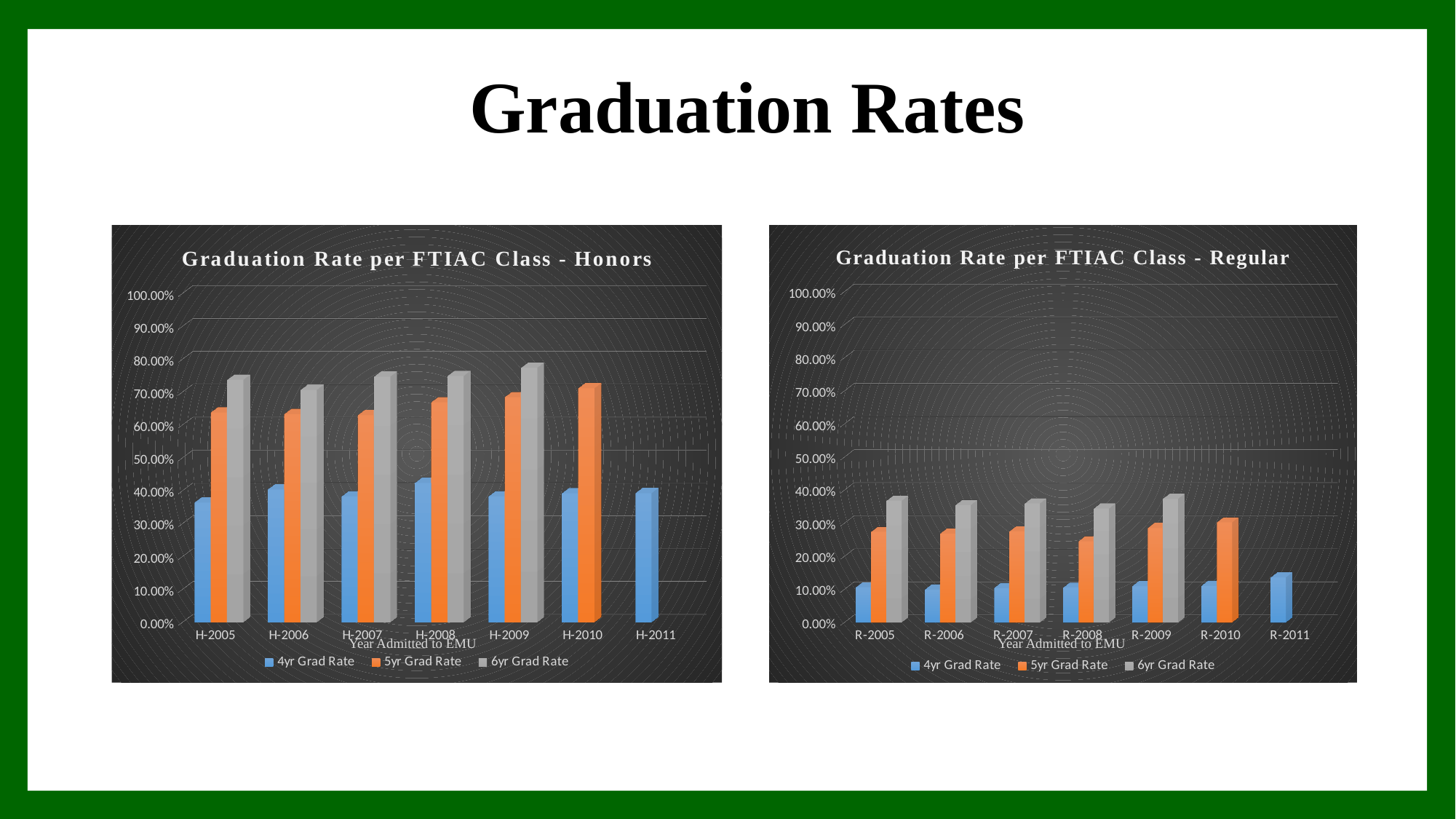
In the 'Graduation Rate per FTIAC Class - Regular' chart, which year has the highest 4yr Grad Rate? R-2011 In the 'Graduation Rate per FTIAC Class - Honors' chart, which is larger: the 5yr Grad Rate for H-2010 or the 5yr Grad Rate for H-2005? H-2010 In the 'Graduation Rate per FTIAC Class - Regular' chart, is the 4yr Grad Rate for R-2005 greater or less than 20.00%? less In the 'Graduation Rate per FTIAC Class - Regular' chart, is the 6yr Grad Rate for R-2005 greater or less than 50.00%? less In the 'Graduation Rate per FTIAC Class - Regular' chart, which is larger for R-2005: the 4yr Grad Rate or the 6yr Grad Rate? 6yr Grad Rate In the 'Graduation Rate per FTIAC Class - Honors' chart, what is the x-axis title? Year Admitted to EMU In the 'Graduation Rate per FTIAC Class - Regular' chart, is the 5yr Grad Rate for R-2010 greater or less than 20.00%? greater In the 'Graduation Rate per FTIAC Class - Honors' chart, what kind of chart is shown? Bar chart In the 'Graduation Rate per FTIAC Class - Regular' chart, how many year categories are shown on the x axis? 7 In the 'Graduation Rate per FTIAC Class - Honors' chart, how many series does the legend list? 3